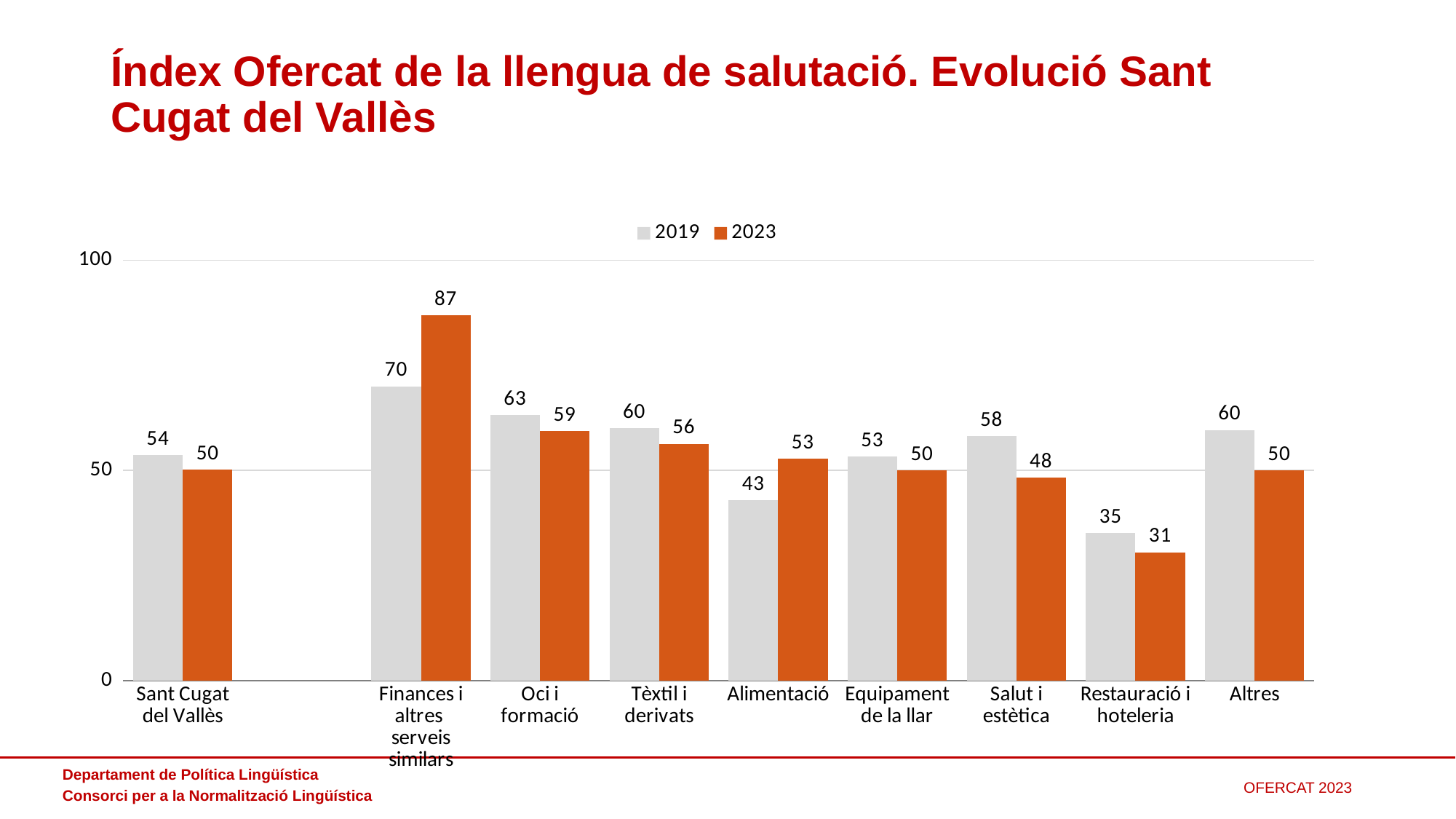
What is the difference between the 2019 and 2023 values for Salut i estètica? 10 How many series does the legend list? 2 Which category has the highest 2023 value? Finances i altres serveis similars Which category has the lowest 2019 value? Restauració i hoteleria What kind of chart is shown on the slide? bar chart What is the 2023 value for Restauració i hoteleria? 31 Is the 2019 value for Oci i formació greater or less than 50? greater What is the 2019 value for Alimentació? 43 Which is larger for Alimentació, the 2019 value or the 2023 value? 2023 What is the 2023 value for Finances i altres serveis similars? 87 How many categories are shown on the x axis? 9 What is the difference between the 2019 and 2023 values for Finances i altres serveis similars? 17